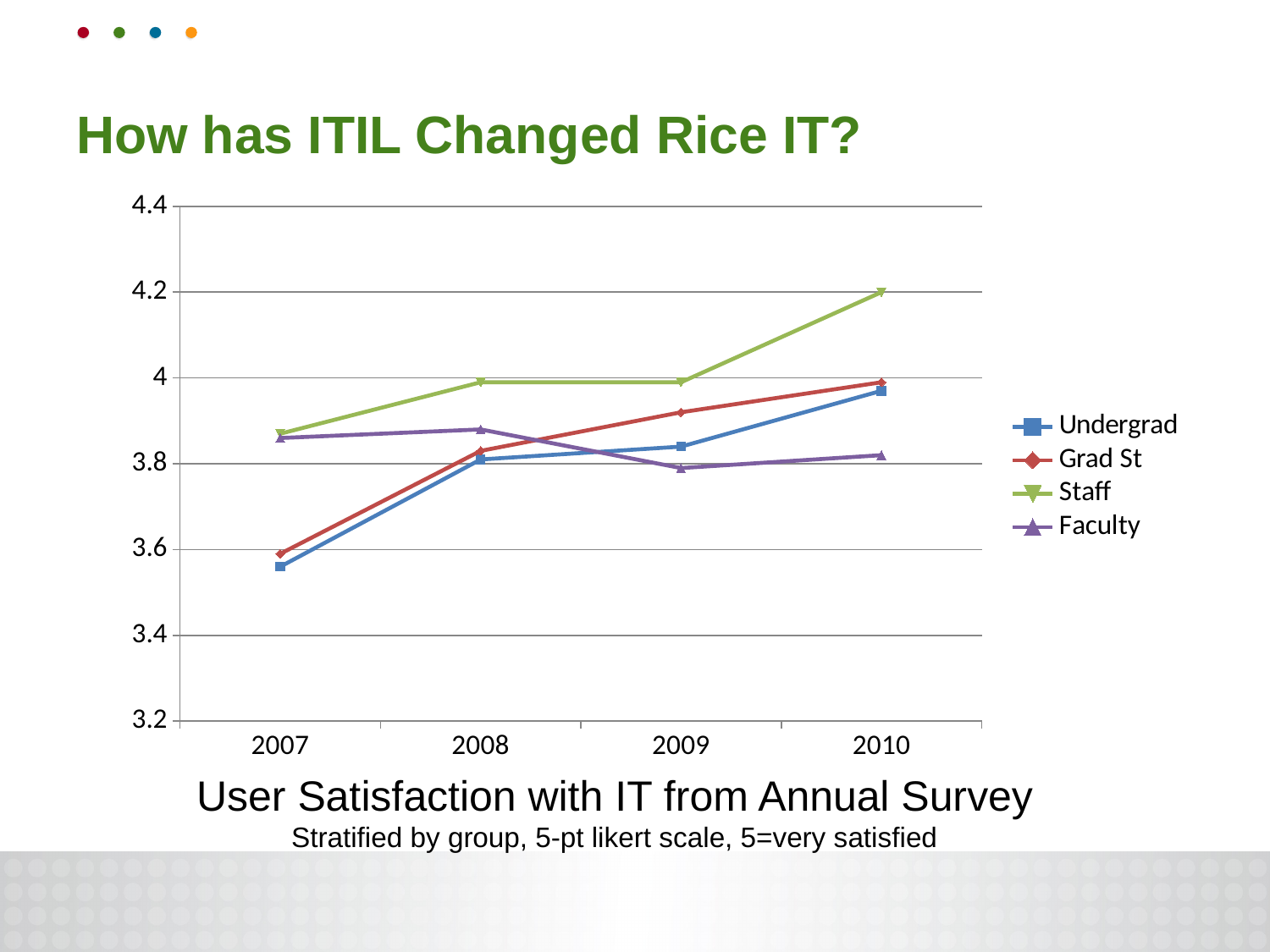
In 2010, which is higher: Staff or Faculty? Staff Is the Undergrad value for 2007 greater or less than 3.8? less Which group has the lowest satisfaction score in 2010? Faculty How many years are shown on the x axis? 4 What kind of chart is shown on the slide? line chart Which group has the highest satisfaction score in 2010? Staff Which series is drawn in green? Staff Is the Staff value for 2010 greater or less than 4? greater Does the Staff line rise or fall from 2007 to 2010? rise What is the title shown below the chart? User Satisfaction with IT from Annual Survey How many series does the legend list? 4 Is the Faculty value for 2010 greater or less than 4? less